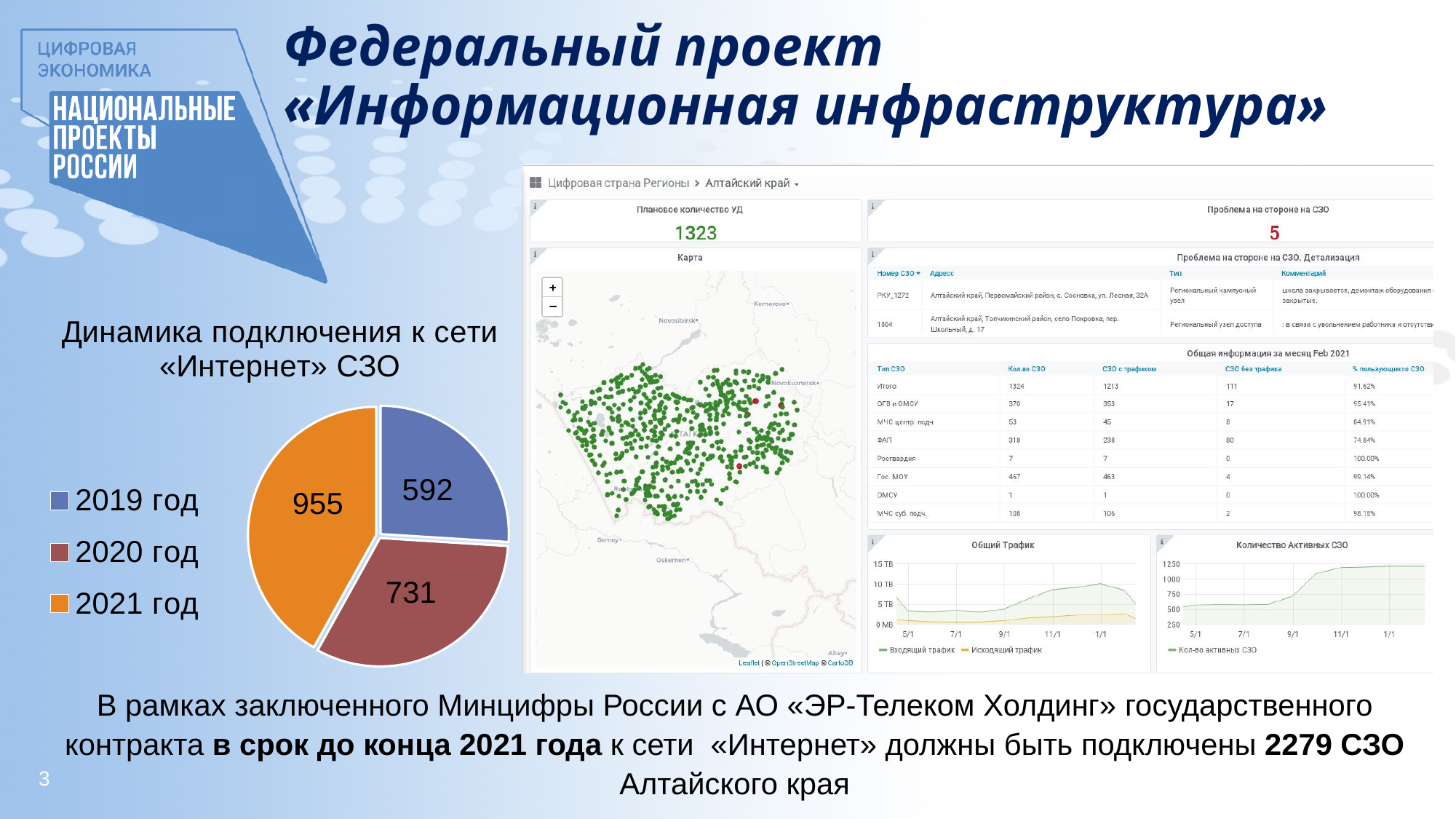
In the pie chart «Динамика подключения к сети «Интернет» СЗО», which year has the largest slice? 2021 год In the pie chart «Динамика подключения к сети «Интернет» СЗО», what is the value for 2020 год? 731 In the pie chart «Динамика подключения к сети «Интернет» СЗО», which year has the smallest slice? 2019 год In the pie chart «Динамика подключения к сети «Интернет» СЗО», which is larger: the value for 2020 год or 2019 год? 2020 год What type of chart is «Динамика подключения к сети «Интернет» СЗО»? Pie chart How many slices does the pie chart «Динамика подключения к сети «Интернет» СЗО» have? 3 In the pie chart «Динамика подключения к сети «Интернет» СЗО», what is the difference between the values for 2021 год and 2019 год? 363 In the pie chart «Динамика подключения к сети «Интернет» СЗО», what is the difference between the values for 2020 год and 2019 год? 139 In the pie chart «Динамика подключения к сети «Интернет» СЗО», what is the total of all three slices? 2278 In the pie chart «Динамика подключения к сети «Интернет» СЗО», which colour represents 2021 год? Orange In the pie chart «Динамика подключения к сети «Интернет» СЗО», what is the value for 2019 год? 592 In the pie chart «Динамика подключения к сети «Интернет» СЗО», what is the value for 2021 год? 955